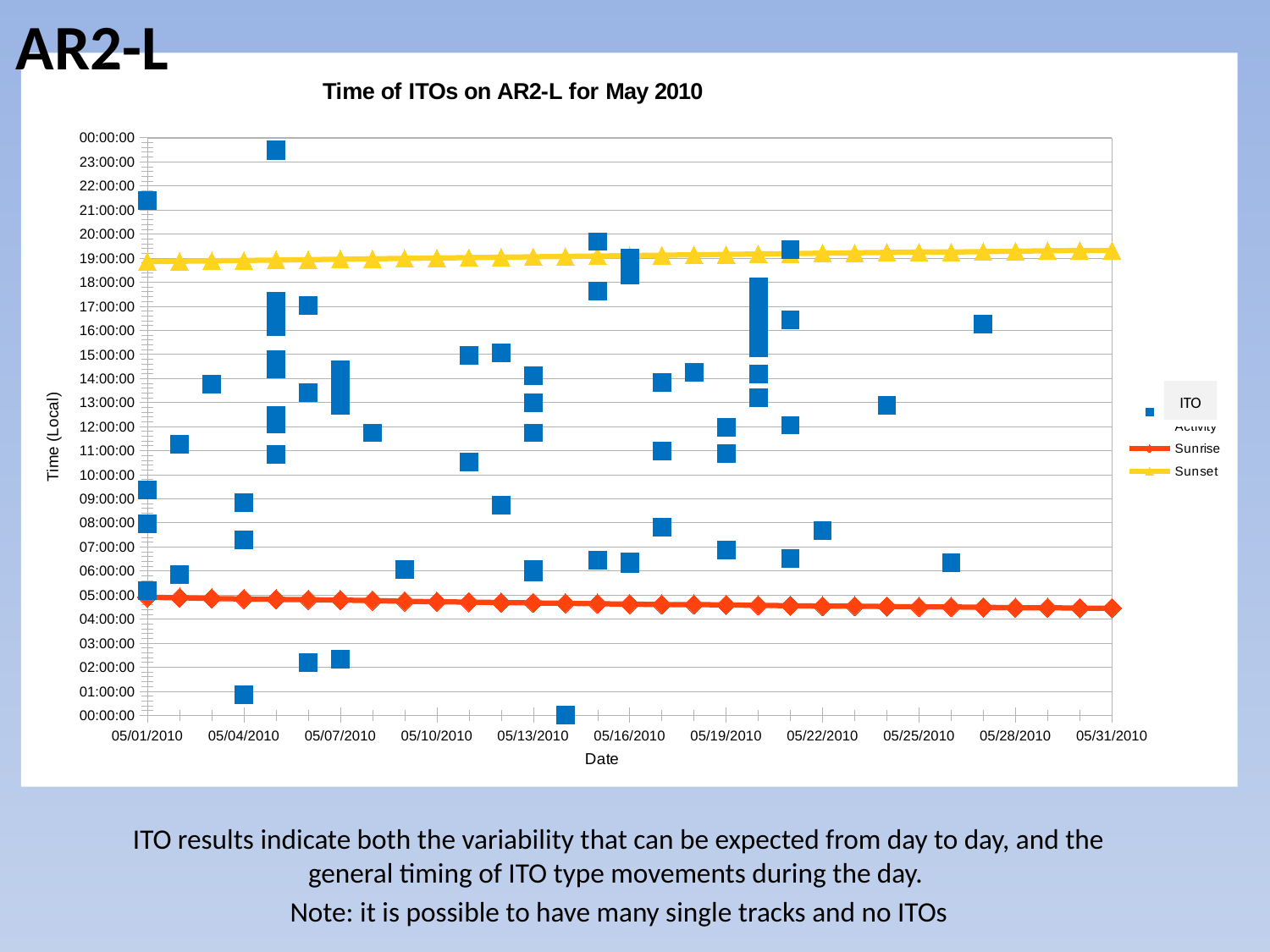
How many date labels are shown on the x axis? 11 Does the Sunrise series rise or fall along the x axis from 05/01/2010 to 05/31/2010? fall Is the Sunset value on 05/31/2010 greater or less than 18:00:00? greater How many series does the chart legend list? 3 What is the label of the y axis? Time (Local) Which is later, the Sunrise value on 05/01/2010 or the Sunrise value on 05/31/2010? 05/01/2010 Is the Sunrise value on 05/31/2010 greater or less than 05:00:00? less Does the Sunset series rise or fall along the x axis from 05/01/2010 to 05/31/2010? rise Is the Sunrise value on 05/01/2010 greater or less than 04:00:00? greater What is the title of the chart? Time of ITOs on AR2-L for May 2010 What kind of chart is shown on the slide? scatter chart Which is later on 05/16/2010, the Sunrise value or the Sunset value? Sunset